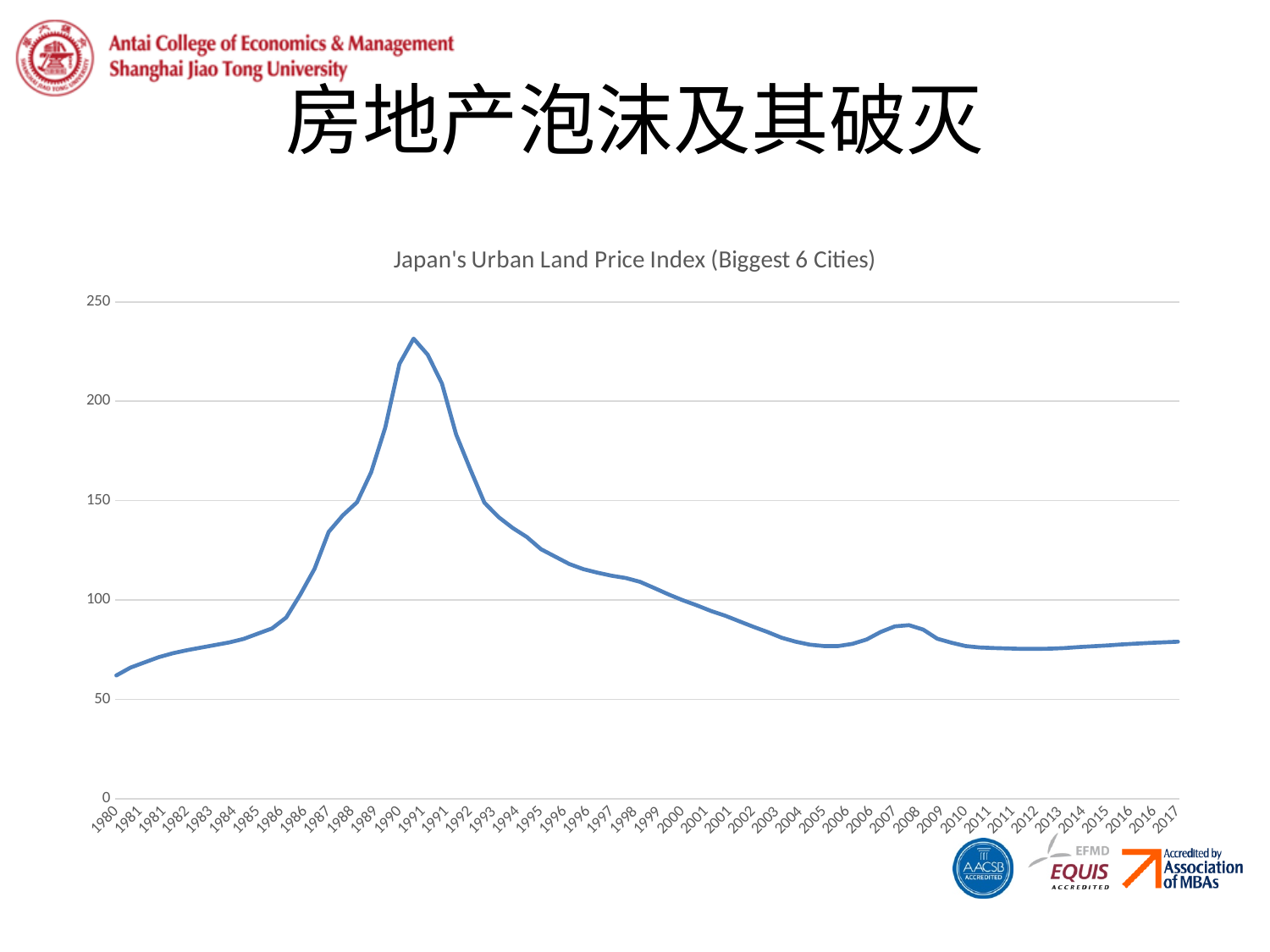
What kind of chart is shown on the slide? line chart Does the land price index rise or fall between 1980 and 1991? rise Is the value for 1991 greater or less than 200? greater Is the value for 1995 greater or less than 100? greater Is the value for 2017 greater or less than 100? less What is the title of the chart? Japan's Urban Land Price Index (Biggest 6 Cities) In which year is the land price index at its lowest value? 1980 In which year does the land price index reach its highest value? 1990 Does the land price index rise or fall between 1991 and 2005? fall Which is larger, the value for 1991 or the value for 2017? 1991